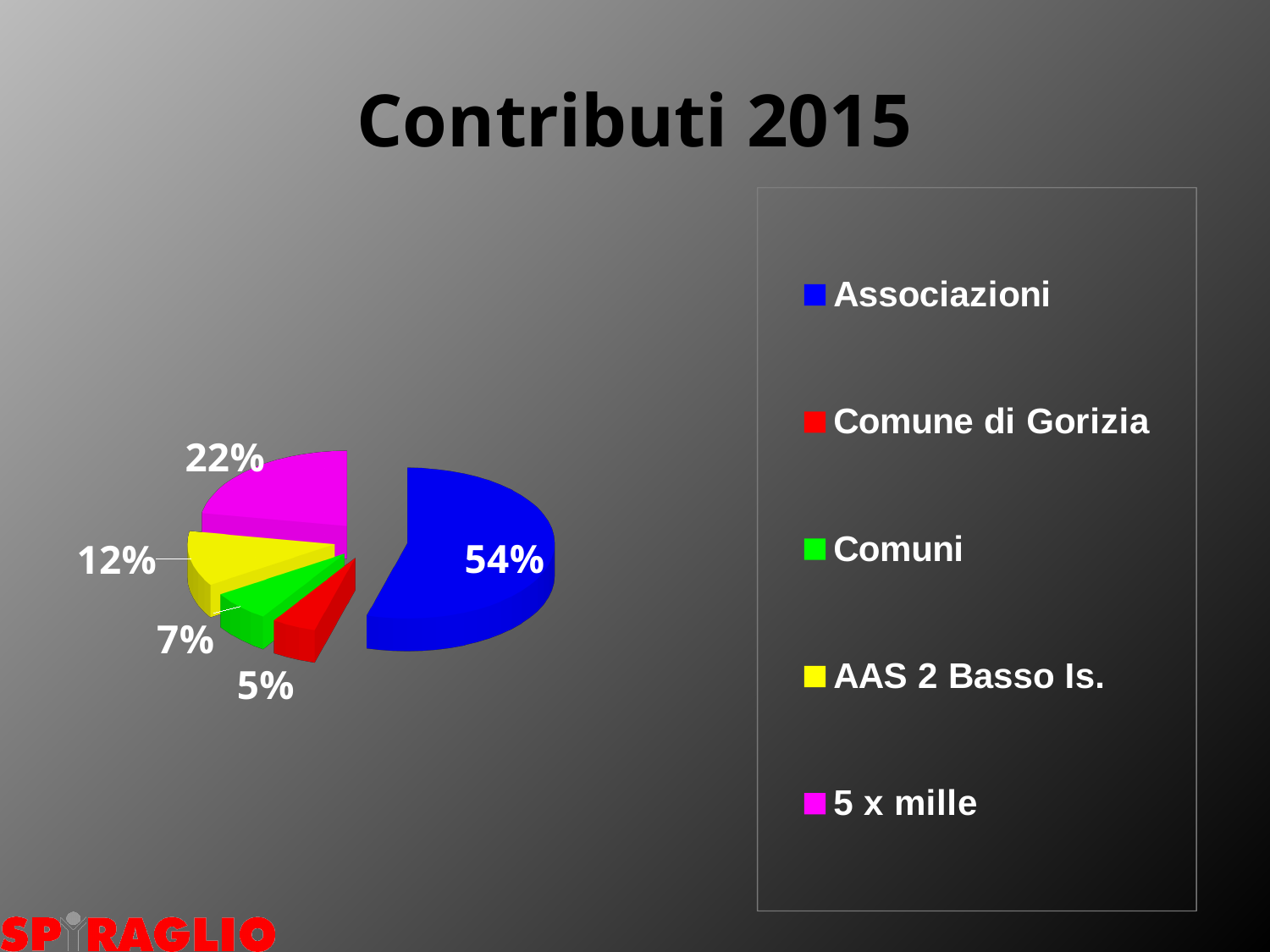
Which category has the smallest share of the pie? Comune di Gorizia Which colour represents Comuni in the legend? green What percentage of the pie does Associazioni account for? 54% What is the difference in percentage points between Associazioni and 5 x mille? 32 How many slices does the pie chart have? 5 What percentage is shown for Comune di Gorizia? 5% Which is larger, the share for Comuni or the share for AAS 2 Basso Is.? AAS 2 Basso Is. Which category has the largest share of the pie? Associazioni What type of chart is shown on the slide? pie chart What is the title of the chart? Contributi 2015 What percentage is shown for AAS 2 Basso Is.? 12% What percentage is shown for 5 x mille? 22%